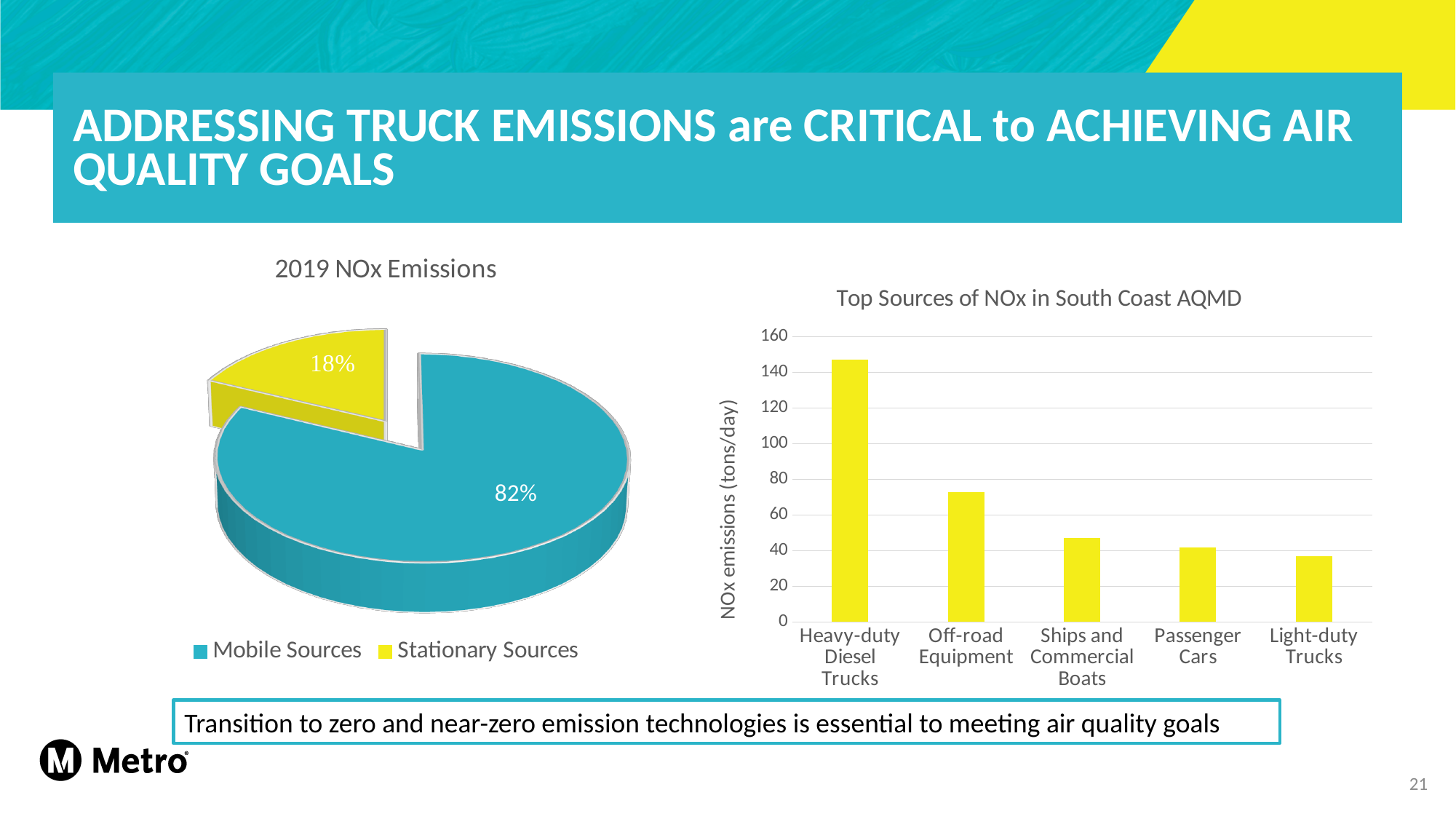
In the 2019 NOx Emissions pie chart, what is the difference in percentage points between Mobile Sources and Stationary Sources? 64 In the Top Sources of NOx in South Coast AQMD chart, which source has the highest NOx emissions? Heavy-duty Diesel Trucks How many entries does the legend of the 2019 NOx Emissions chart list? 2 In the Top Sources of NOx in South Coast AQMD chart, is the value for Off-road Equipment greater or less than 80? less In the Top Sources of NOx in South Coast AQMD chart, is the value for Heavy-duty Diesel Trucks greater or less than 140? greater In the 2019 NOx Emissions pie chart, what share is Mobile Sources? 82% How many categories are shown in the Top Sources of NOx in South Coast AQMD chart? 5 In the 2019 NOx Emissions pie chart, what share is Stationary Sources? 18% What kind of chart is the 2019 NOx Emissions chart? Pie chart In the 2019 NOx Emissions pie chart, which slice is larger, Mobile Sources or Stationary Sources? Mobile Sources What kind of chart is the Top Sources of NOx in South Coast AQMD chart? Bar chart In the Top Sources of NOx in South Coast AQMD chart, which is larger, Off-road Equipment or Ships and Commercial Boats? Off-road Equipment